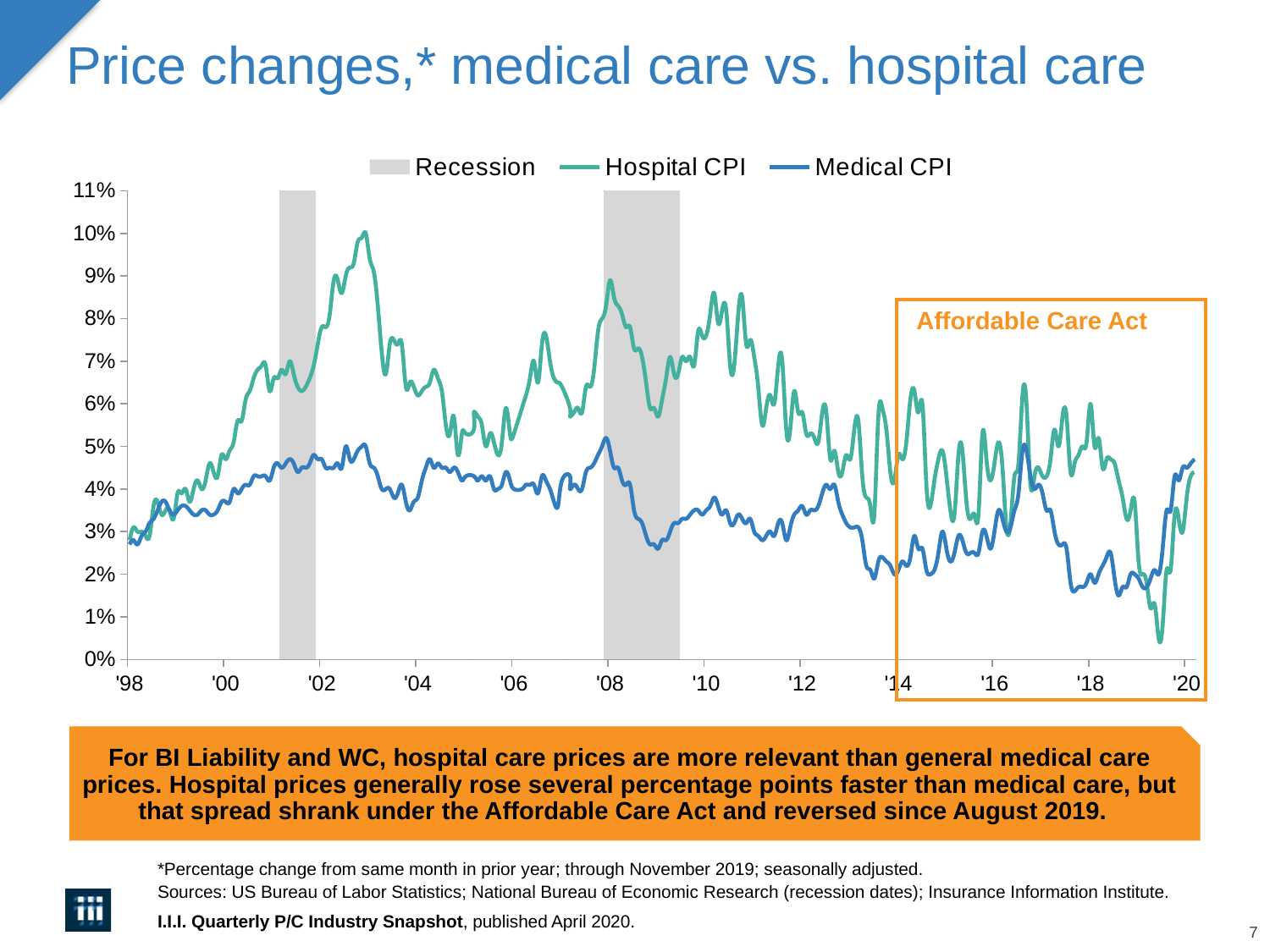
Is the Medical CPI value around 2018 greater or less than 3%? less Which series reaches the highest value anywhere on the chart, Hospital CPI or Medical CPI? Hospital CPI How many shaded recession periods are shown on the chart? 2 What is the label inside the orange box on the right side of the chart? Affordable Care Act What kind of chart is shown on the slide? line chart Around 2018, which series is higher, Hospital CPI or Medical CPI? Hospital CPI What is the highest value shown on the vertical axis of the chart? 11% Is the peak value of Hospital CPI around 2003 greater or less than 9%? greater How many entries does the chart legend list? 3 Is the lowest Hospital CPI value in 2019 greater or less than 1%? less Around 2003, which series is higher, Hospital CPI or Medical CPI? Hospital CPI